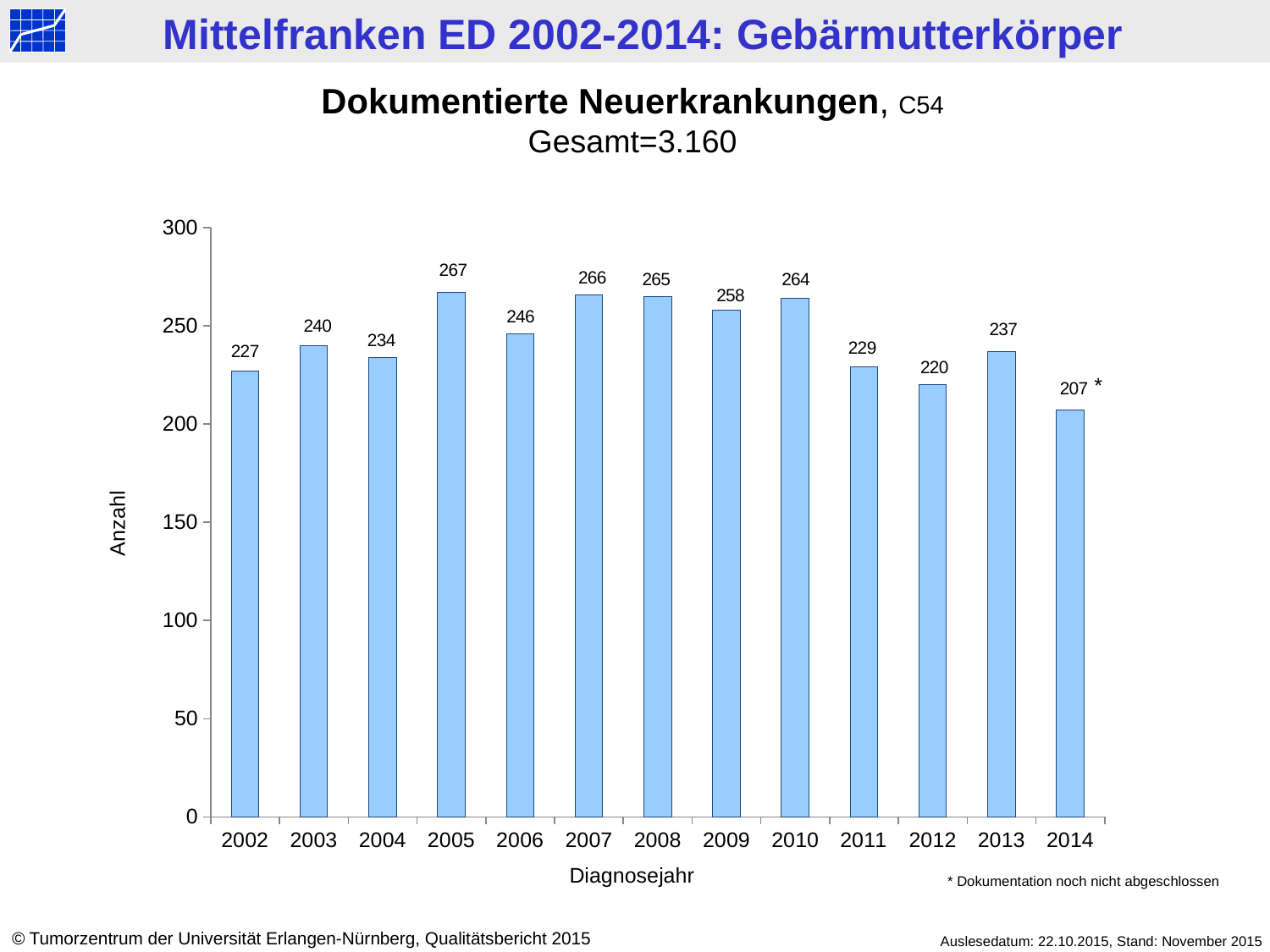
Which year has the lowest value? 2014 Which is larger, the value for 2003 or the value for 2013? 2003 How many years are shown on the x axis? 13 What is the value for 2005? 267 Which year has the highest value? 2005 Is the value for 2012 greater or less than 250? less What kind of chart is shown? bar chart What is the value for 2009? 258 What is the label of the y axis? Anzahl What is the value for 2014? 207 Do the values rise or fall from 2010 to 2012? fall What is the difference between the values for 2005 and 2014? 60